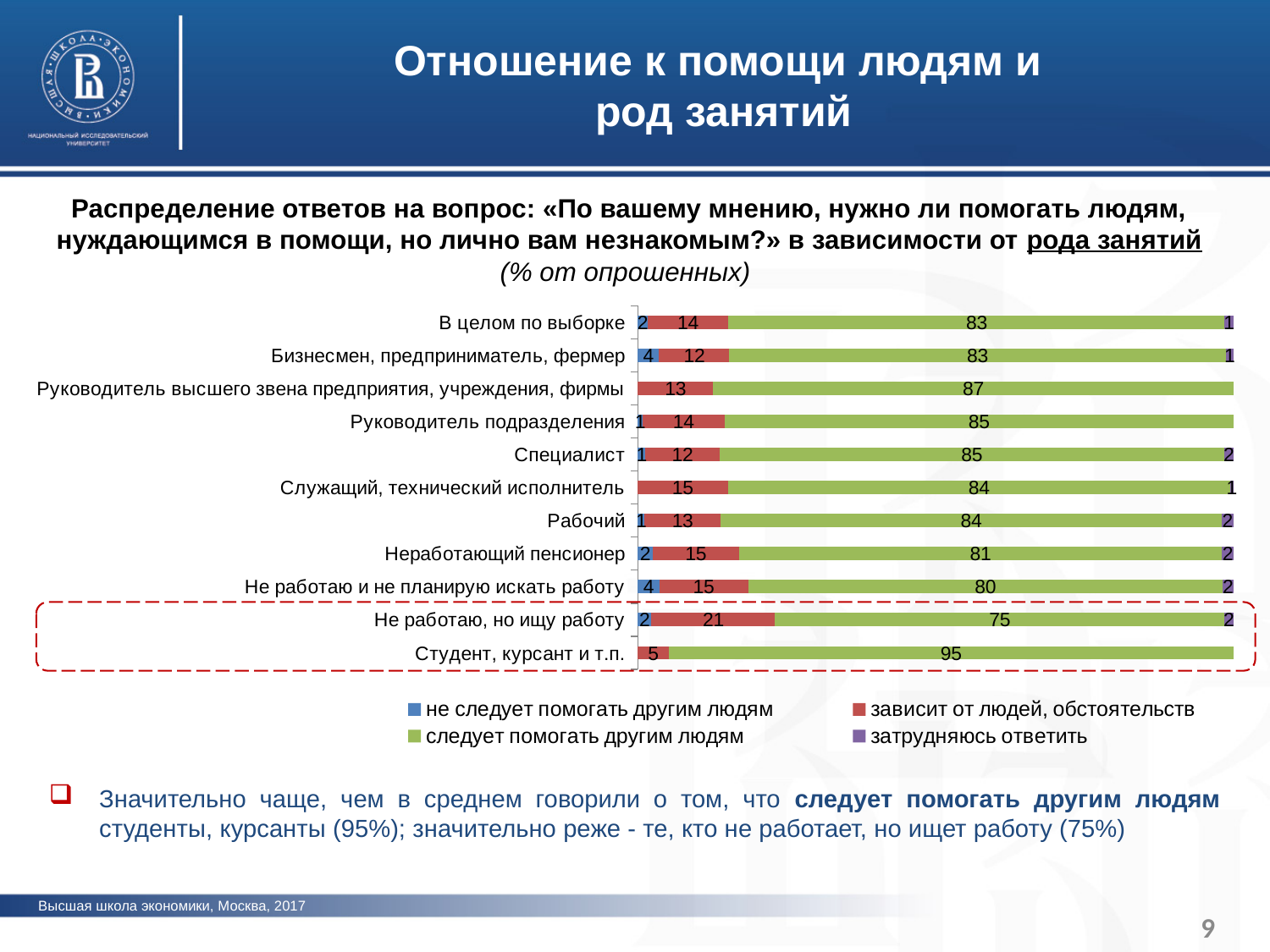
What is the value of «следует помогать другим людям» for «Руководитель высшего звена предприятия, учреждения, фирмы»? 87 Which is larger: the «зависит от людей, обстоятельств» value for «Неработающий пенсионер» or for «Специалист»? Неработающий пенсионер What is the value of «следует помогать другим людям» for «В целом по выборке»? 83 What type of chart is shown on the slide? stacked bar chart How many series does the legend list? 4 What is the value of «зависит от людей, обстоятельств» for «Не работаю, но ищу работу»? 21 What is the value of «следует помогать другим людям» for «Студент, курсант и т.п.»? 95 Which category has the highest value for «следует помогать другим людям»? Студент, курсант и т.п. How many occupation categories are plotted in the chart? 11 Which category has the lowest value for «следует помогать другим людям»? Не работаю, но ищу работу What is the difference between the «следует помогать другим людям» values for «Студент, курсант и т.п.» and «Не работаю, но ищу работу»? 20 Which legend entry is shown in green? следует помогать другим людям